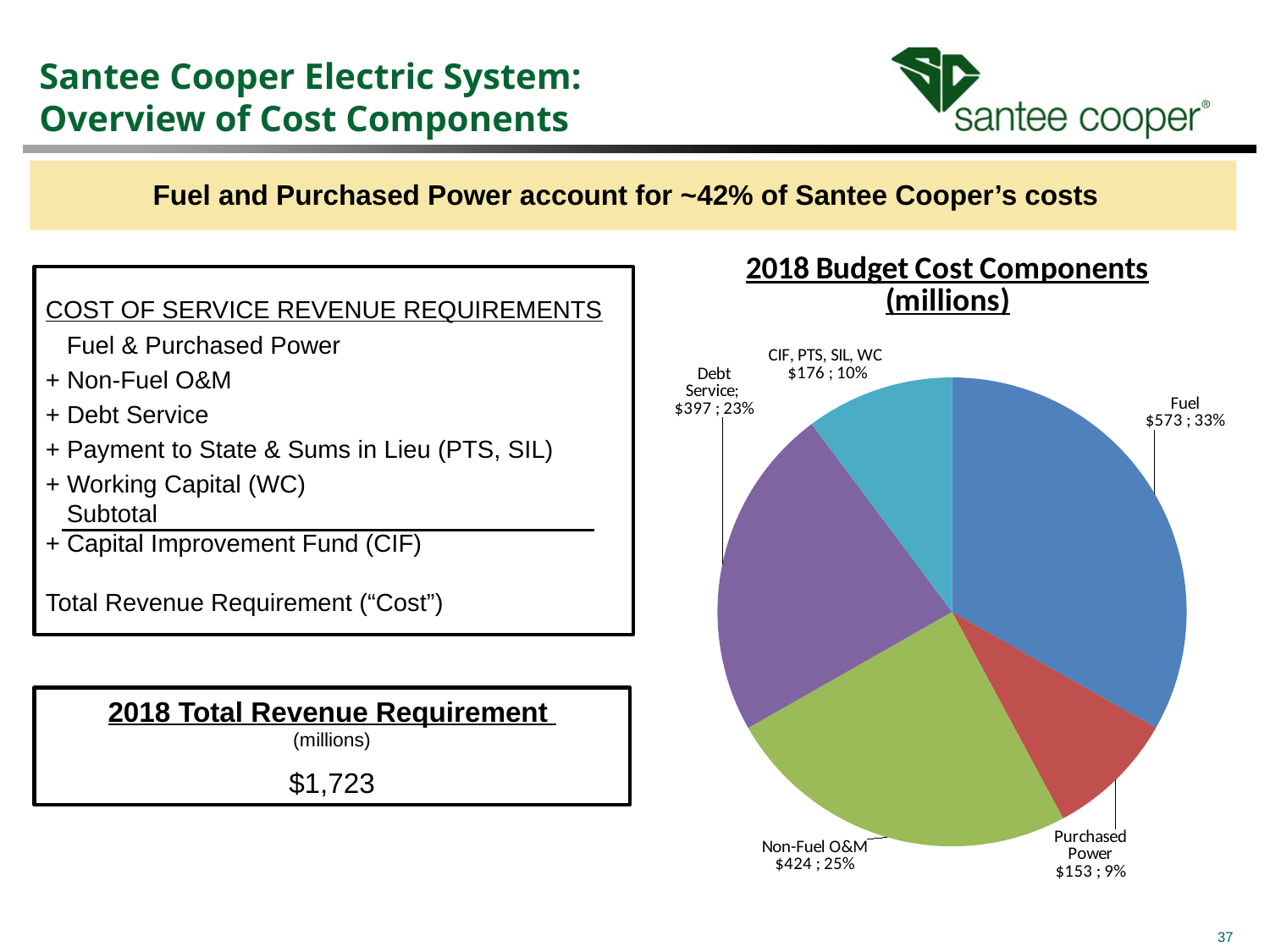
What is the value for Purchased Power in the pie chart? $153 What share of the pie does CIF, PTS, SIL, WC account for? 10% What share of the pie does Debt Service account for? 23% Which is larger in the pie chart, Debt Service or Purchased Power? Debt Service What is the difference between the Fuel value and the Non-Fuel O&M value in the pie chart? $149 What is the value for Fuel in the 2018 Budget Cost Components pie chart? $573 Which category has the largest slice in the pie chart? Fuel How many slices does the pie chart have? 5 What type of chart is shown on the slide? Pie chart What is the value for Non-Fuel O&M in the pie chart? $424 What is the value for Debt Service in the pie chart? $397 Which category has the smallest slice in the pie chart? Purchased Power